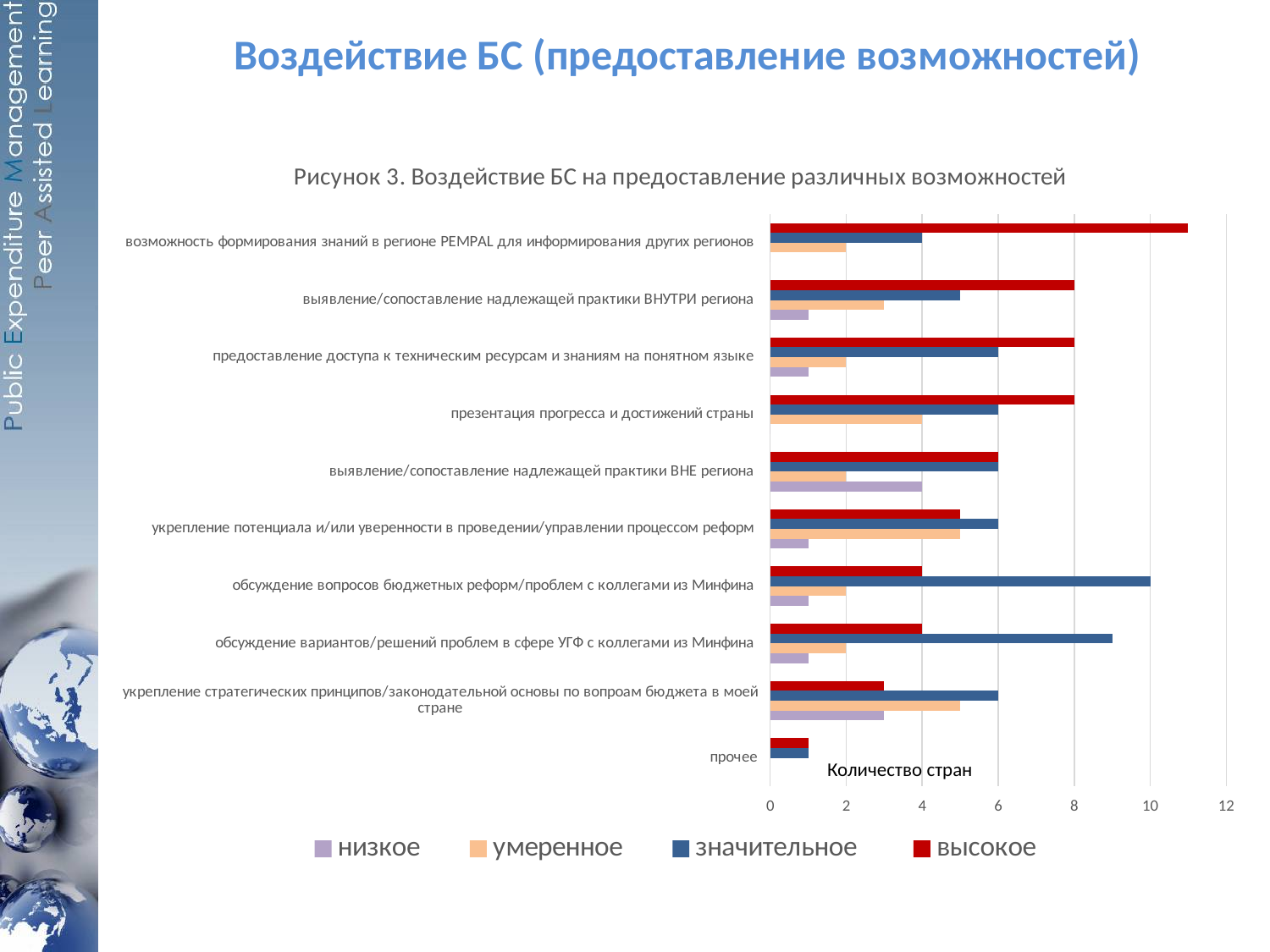
What is the value of the 'значительное' series for 'возможность формирования знаний в регионе PEMPAL для информирования других регионов'? 4 What kind of chart is shown on the slide? bar chart Is the 'значительное' value for 'обсуждение вариантов/решений проблем в сфере УГФ с коллегами из Минфина' greater or less than 8? greater Which category has the highest 'высокое' value? возможность формирования знаний в регионе PEMPAL для информирования других регионов How many series does the legend list? 4 What is the value of the 'низкое' series for 'выявление/сопоставление надлежащей практики ВНЕ региона'? 4 How many categories are plotted on the chart? 10 What is the value of the 'высокое' series for 'выявление/сопоставление надлежащей практики ВНУТРИ региона'? 8 Is the 'высокое' value for 'возможность формирования знаний в регионе PEMPAL для информирования других регионов' greater or less than 10? greater Which is larger for 'обсуждение вопросов бюджетных реформ/проблем с коллегами из Минфина': the 'значительное' value or the 'высокое' value? значительное What is the value of the 'значительное' series for 'обсуждение вопросов бюджетных реформ/проблем с коллегами из Минфина'? 10 What is the difference between the 'высокое' value for 'презентация прогресса и достижений страны' and the 'высокое' value for 'обсуждение вопросов бюджетных реформ/проблем с коллегами из Минфина'? 4